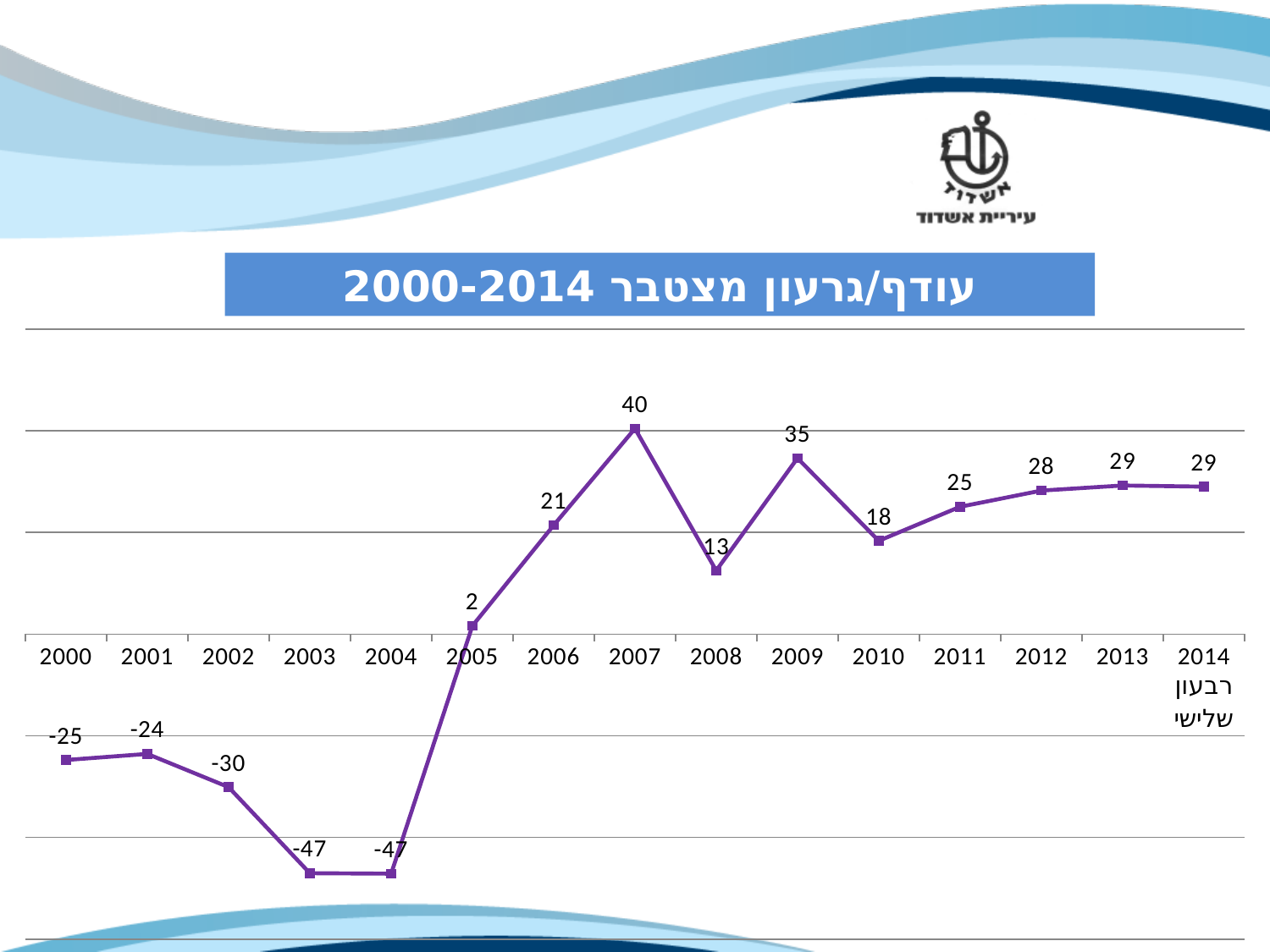
What is the value for 2003? -47 What is the value for 2005? 2 Which is larger, the value for 2009 or the value for 2011? 2009 What is the difference between the values for 2007 and 2008? 27 Which year has the highest value? 2007 Which year has the lowest value? 2003 and 2004 What is the value for 2007? 40 What type of chart is shown on the slide? line chart What is the value for 2010? 18 How many data points are plotted on the chart? 15 Do the values rise or fall from 2010 to 2013? rise What is the title of the chart? עודף/גרעון מצטבר 2000-2014